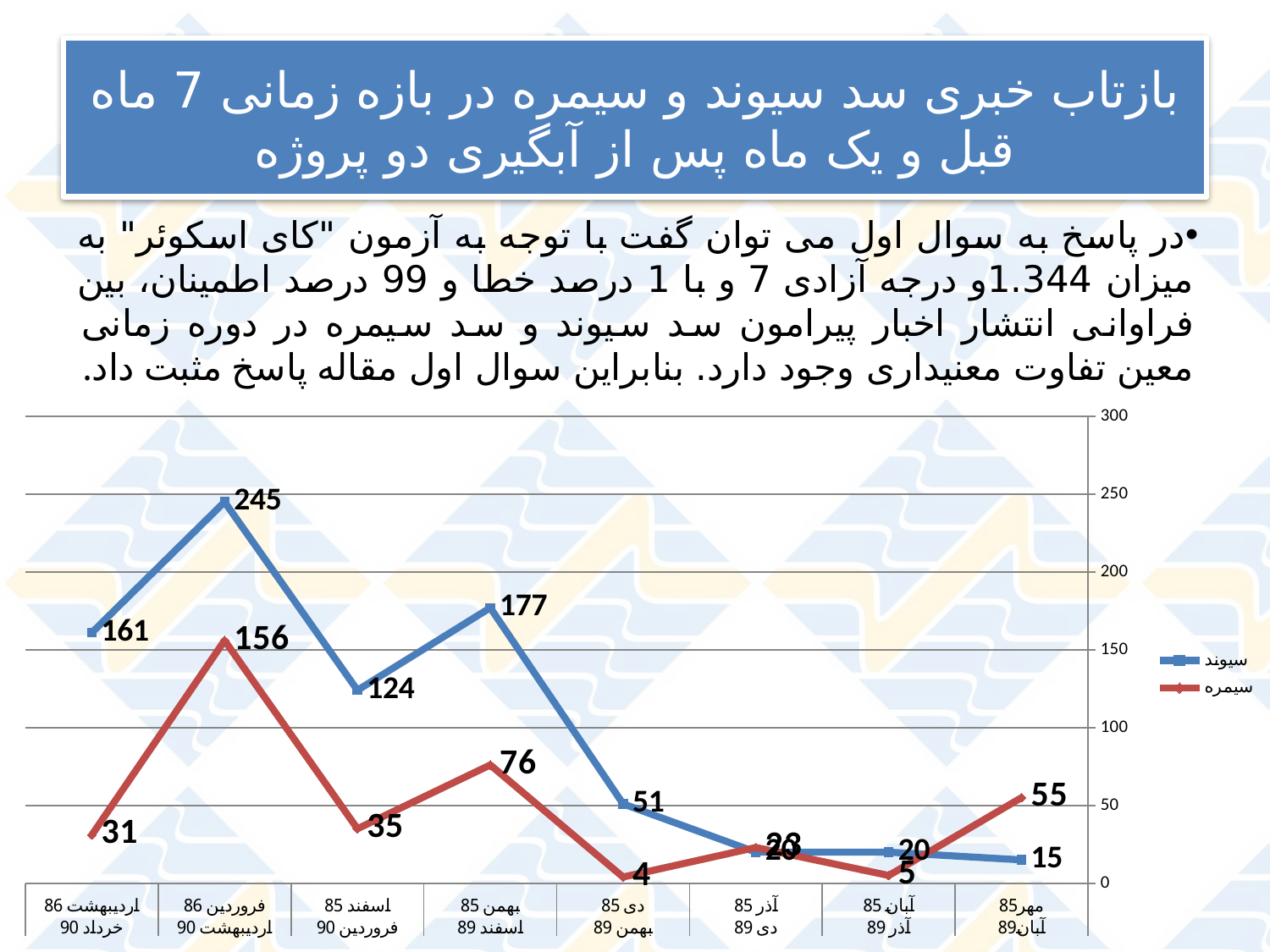
Which series is drawn in red? سیمره At which category does سیمره have its lowest value? دی 85 / بهمن 89 How many categories are shown on the x axis? 8 Is the value for سیوند at بهمن 85 / اسفند 89 greater or less than 150? greater What kind of chart is shown on the slide? line chart How many series does the legend list? 2 What is the difference between سیوند and سیمره at فروردین 86 / اردیبهشت 90? 89 What is the value for سیمره at مهر 85 / آبان 89? 55 At اسفند 85 / فروردین 90, which series has the larger value, سیوند or سیمره? سیوند What is the value for سیوند at اردیبهشت 86 / خرداد 90? 161 At which category does سیوند reach its highest value? فروردین 86 / اردیبهشت 90 What is the value for سیمره at بهمن 85 / اسفند 89? 76